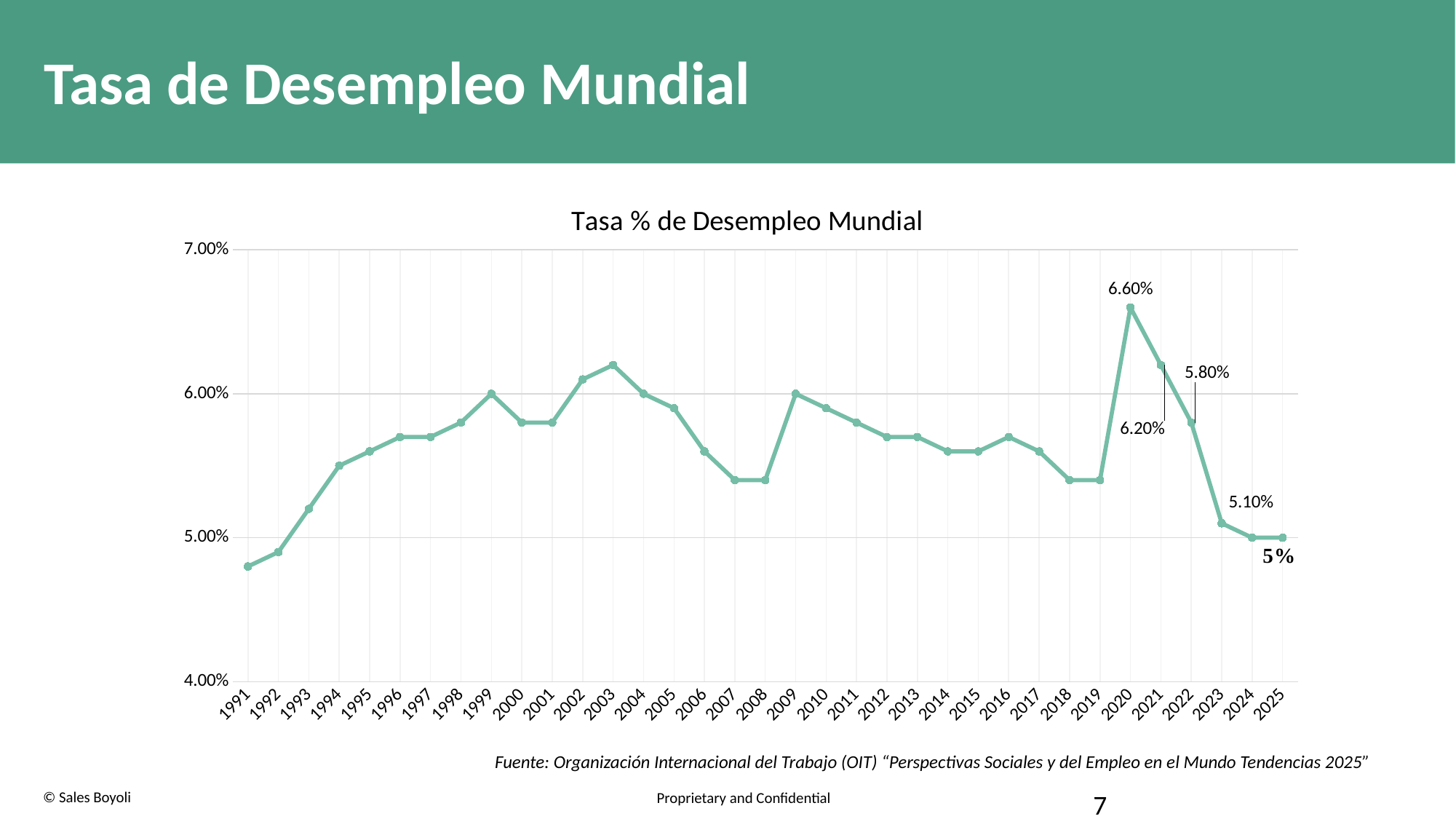
Which is larger, the value for 2021 or the value for 2022? 2021 What is the value for 2025? 5% What is the value for 2023? 5.10% Do the values rise or fall from 2020 to 2023? fall What is the value for 2022? 5.80% Which year has the highest unemployment rate? 2020 Is the value for 1991 greater or less than 5.00%? less What is the difference between the values for 2020 and 2023? 1.50% What kind of chart is shown? line chart What is the value for 2020? 6.60% How many years are plotted on the x axis? 35 Which year has the lowest unemployment rate? 1991